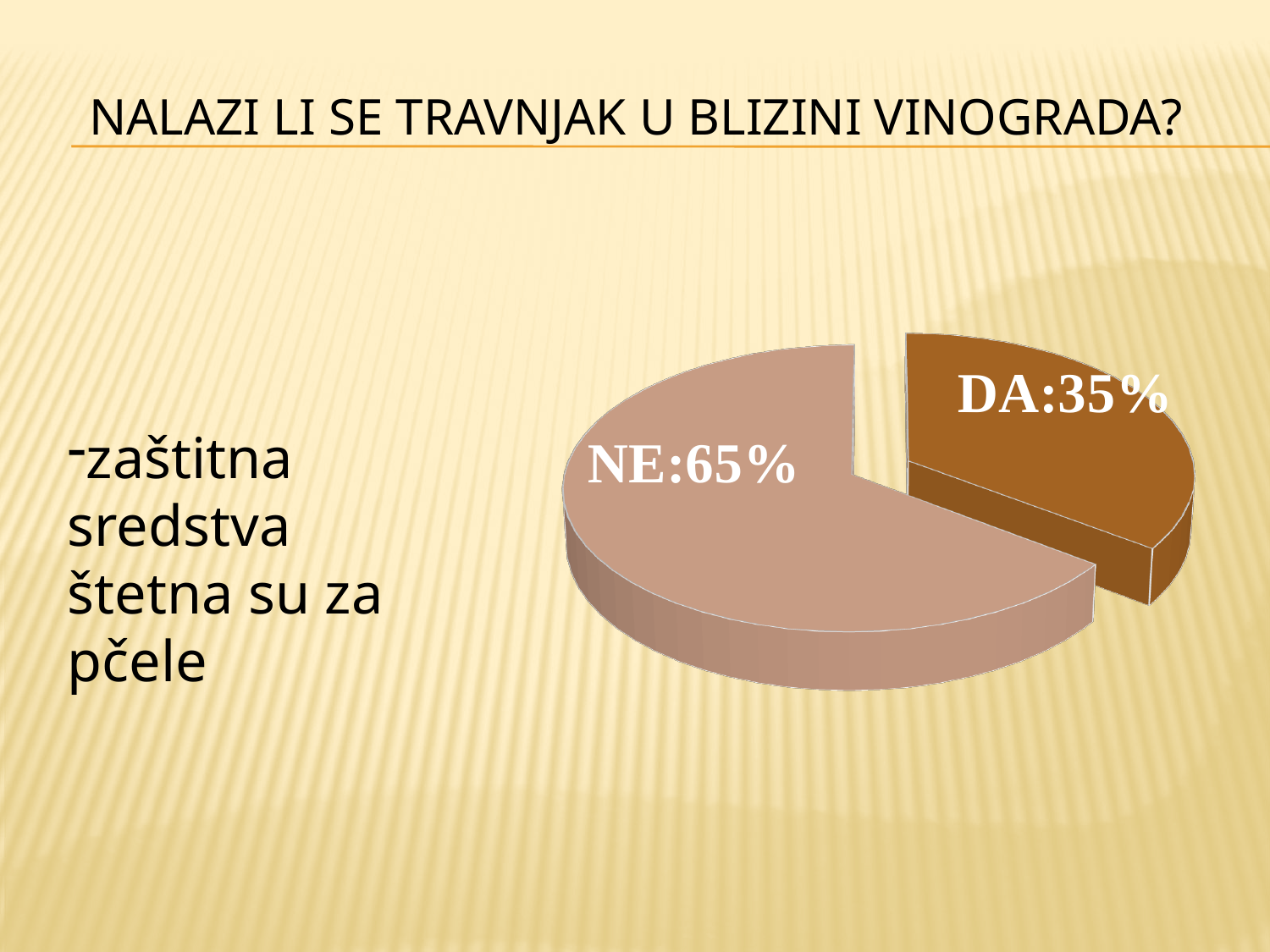
What is the difference between the NE and DA values? 30% What is the total of the two slices in the pie chart? 100% Which slice of the pie chart is the largest? NE What share of the pie does the DA slice represent? 35% What is the value for NE in the pie chart? 65% Which is larger, the value for DA or the value for NE? NE How many slices does the pie chart have? 2 What colour is the DA slice of the pie chart? brown What is the title of the slide containing the pie chart? NALAZI LI SE TRAVNJAK U BLIZINI VINOGRADA? Which slice of the pie chart is the smallest? DA What kind of chart is shown on the slide? pie chart What is the value for DA in the pie chart? 35%